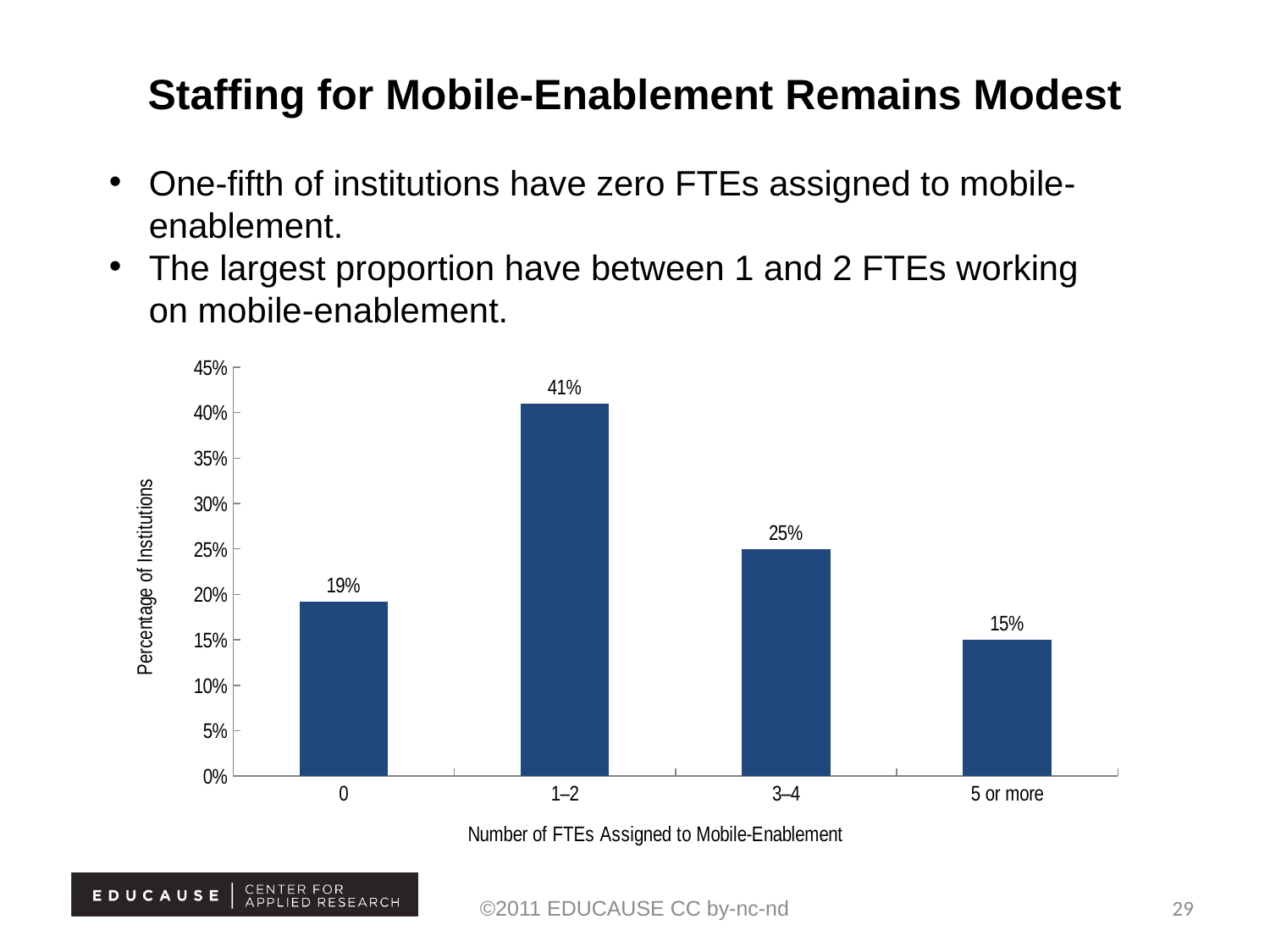
What percentage of institutions have 5 or more FTEs assigned to mobile-enablement? 15% Which FTE category has the highest percentage of institutions? 1–2 What is the label of the y axis? Percentage of Institutions What kind of chart is shown on the slide? Bar chart Is the value for the 3–4 FTE category greater or less than 20%? greater What percentage of institutions have 0 FTEs assigned to mobile-enablement? 19% What percentage of institutions have 1–2 FTEs assigned to mobile-enablement? 41% Which FTE category has the lowest percentage of institutions? 5 or more How many FTE categories are shown on the x axis? 4 Which has a larger percentage of institutions: 0 FTEs or 5 or more FTEs? 0 What is the difference in percentage points between the 1–2 FTE category and the 3–4 FTE category? 16 What percentage of institutions have 3–4 FTEs assigned to mobile-enablement? 25%